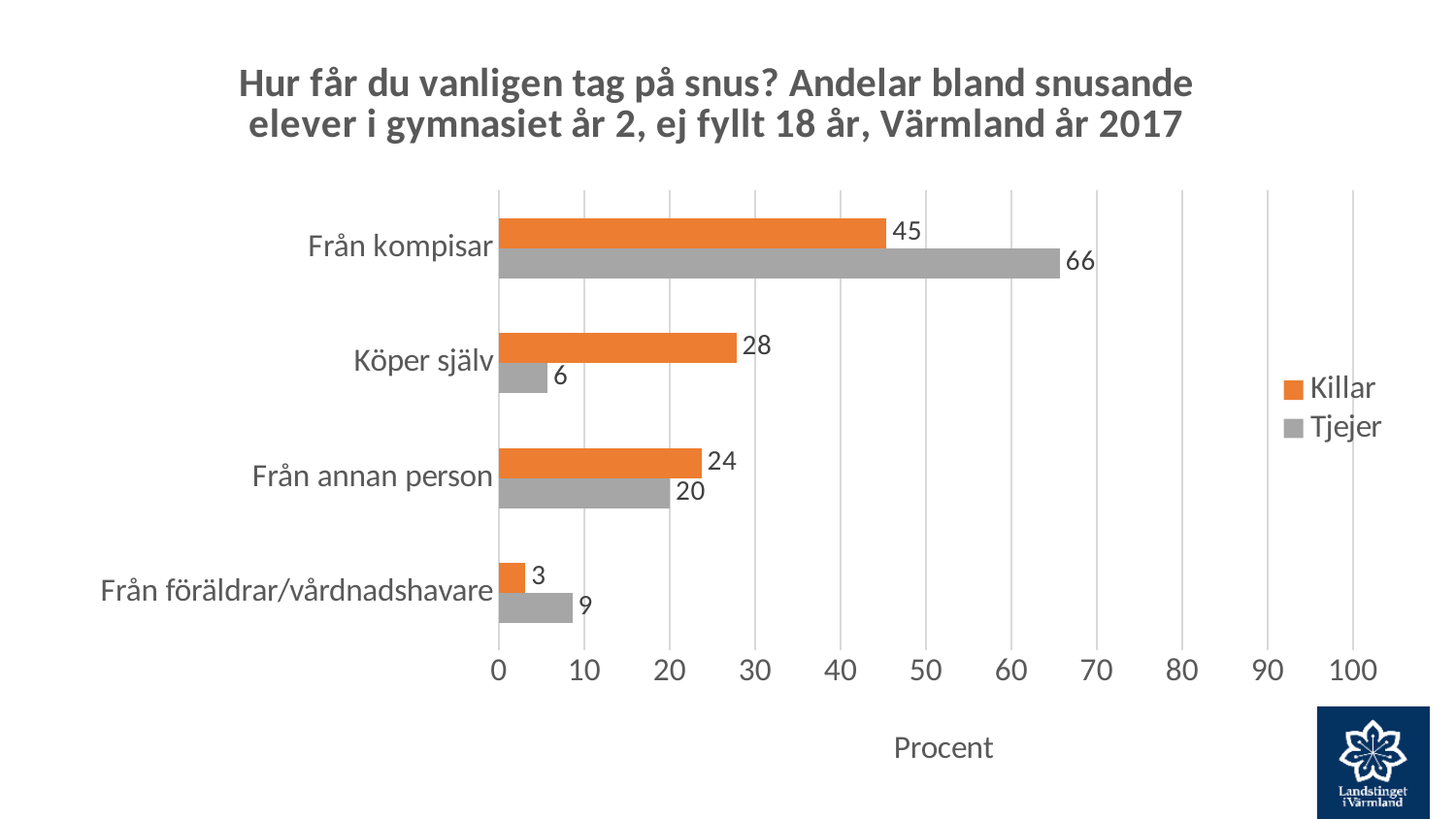
Which category has the highest value for Tjejer? Från kompisar What is the difference between the Tjejer and Killar values for Från kompisar? 21 What is the value for Killar in the Från föräldrar/vårdnadshavare category? 3 Which is larger for Köper själv, the Killar value or the Tjejer value? Killar What kind of chart is shown on the slide? Bar chart What is the value for Killar in the Från kompisar category? 45 How many categories are shown on the chart? 4 How many series does the legend list? 2 What is the value for Tjejer in the Köper själv category? 6 Which category has the lowest value for Killar? Från föräldrar/vårdnadshavare What is the value for Tjejer in the Från kompisar category? 66 Is the value for Tjejer in Från annan person greater or less than 30? less